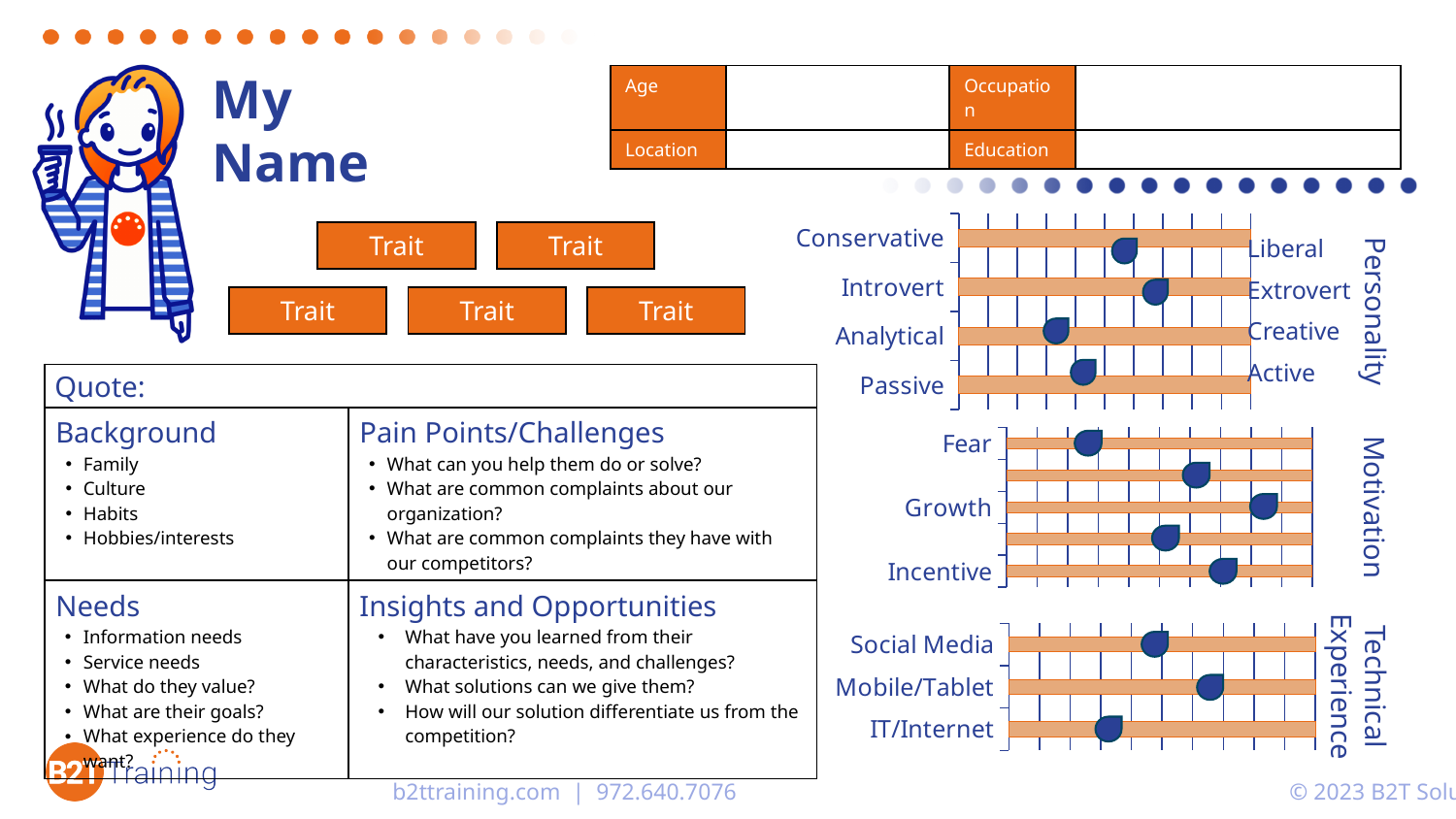
How many bars (rows) does the Technical Experience chart have? 3 In the Technical Experience chart, which category has its marker furthest to the right? Mobile/Tablet What are the titles of the three slider charts on the right side of the slide? Personality, Motivation, Technical Experience How many bars (rows) does the Motivation chart have? 5 In the Personality chart, which row has its marker furthest to the right? Introvert/Extrovert In the Technical Experience chart, which category has its marker furthest to the left? IT/Internet How many bars (rows) does the Personality chart have? 4 In the Personality chart, which row has its marker furthest to the left? Analytical/Creative In the Personality chart, is the marker on the Conservative/Liberal row further right or further left than the marker on the Analytical/Creative row? further right In the Personality chart, what label appears at the right end of the Introvert row? Extrovert In the Motivation chart, which labelled row has its marker furthest to the left? Fear What kind of chart is the Personality chart on the right of the slide? bar chart